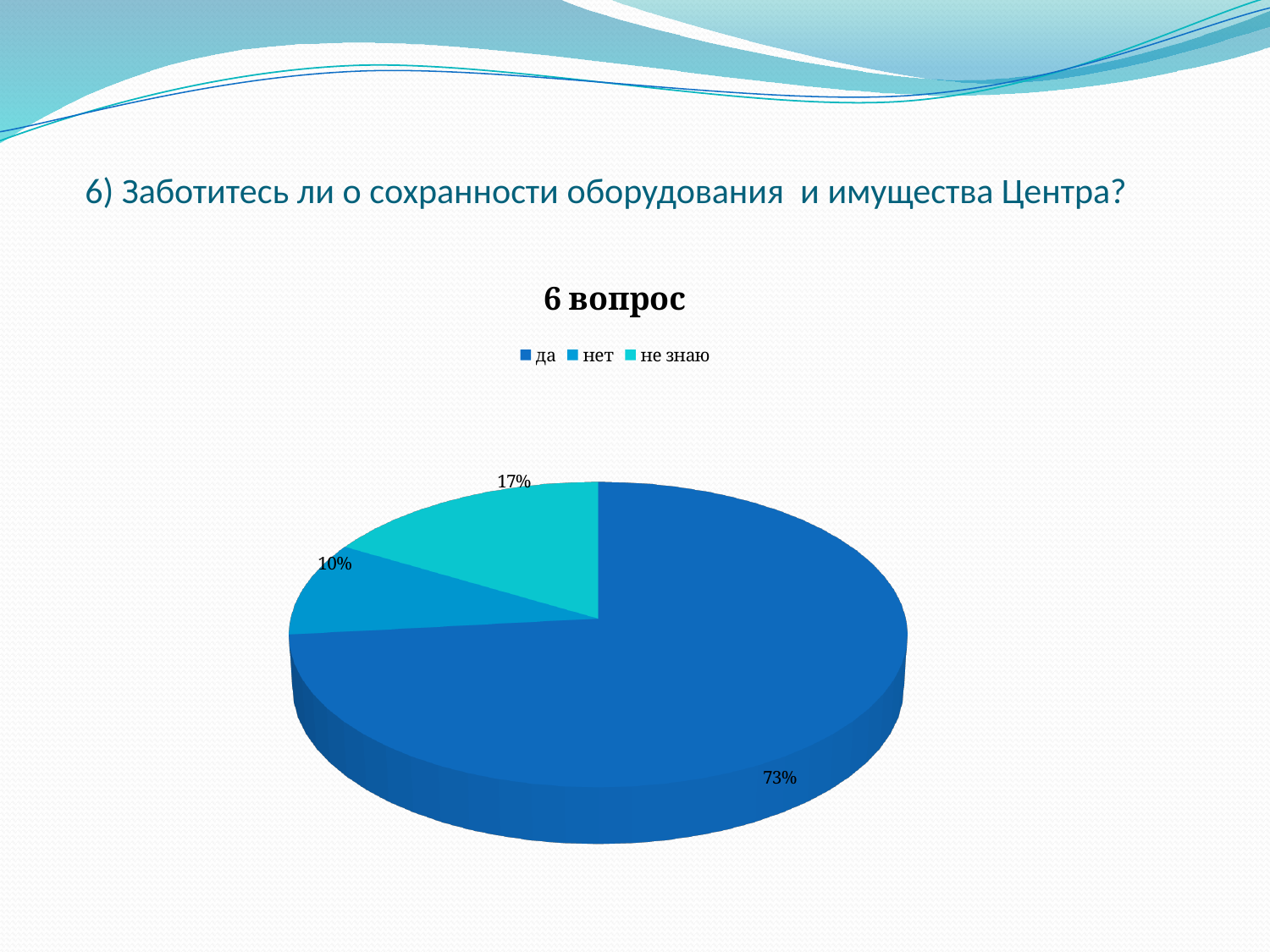
Which is larger, the 'нет' slice or the 'не знаю' slice? не знаю What share of the pie is labelled 'да'? 73% What kind of chart is shown on the slide? pie chart Which category has the largest slice? да How many entries does the legend list? 3 What is the chart's title? 6 вопрос What is the difference between the 'да' and 'не знаю' shares? 56% Which category has the smallest slice? нет What share of the pie is labelled 'не знаю'? 17% How many slices does the pie chart have? 3 What share of the pie is labelled 'нет'? 10% What are the legend entries, in order? да, нет, не знаю